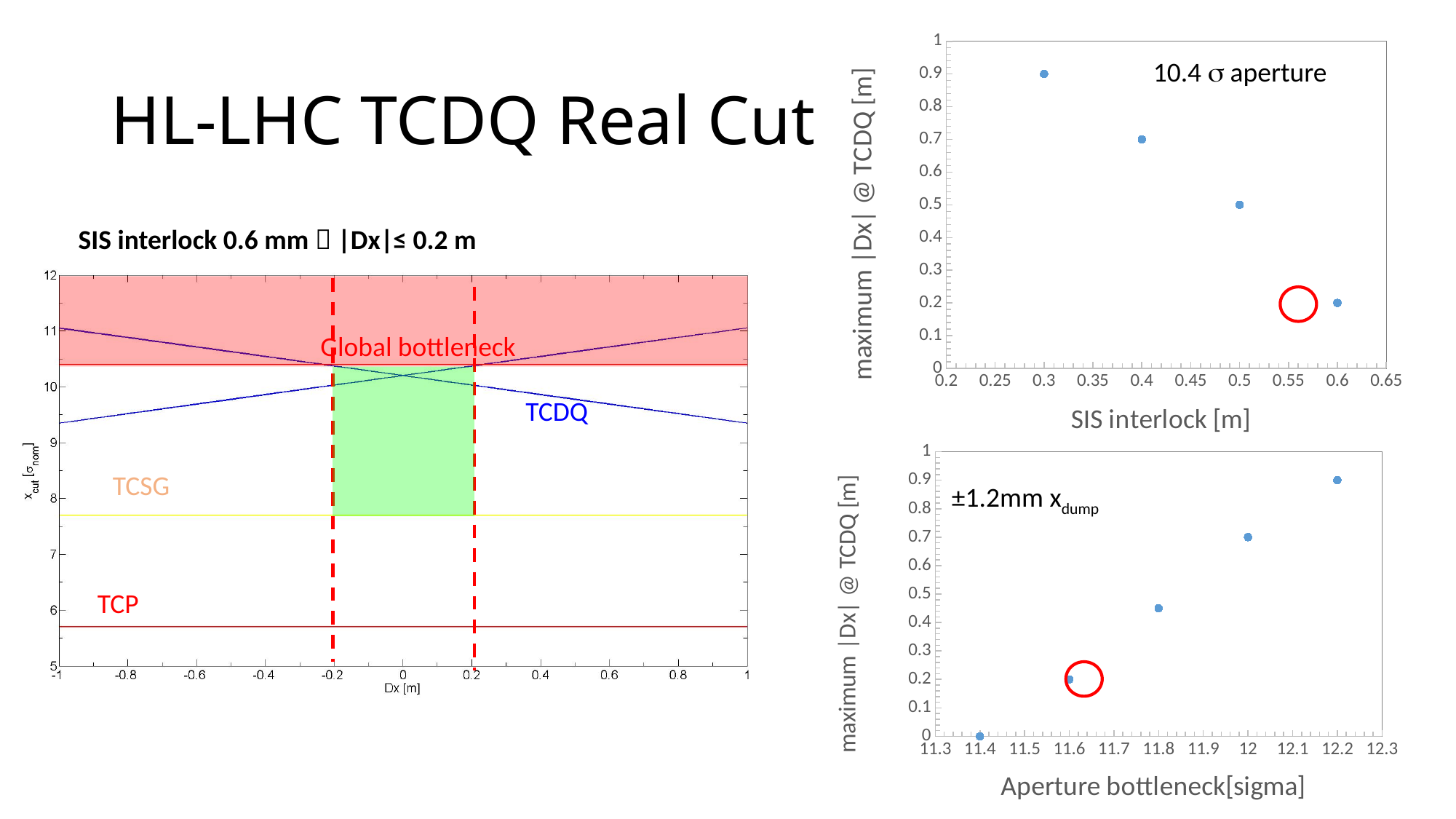
In the bottom-right chart (Aperture bottleneck[sigma]), how many data points are plotted? 5 What kind of chart is the top-right chart with x axis 'SIS interlock [m]'? scatter chart In the top-right chart (SIS interlock [m]), is the value at SIS interlock 0.3 greater or less than 0.8? greater In the top-right chart (SIS interlock [m]), how many data points are plotted? 4 In the top-right chart (SIS interlock [m]), do the values rise or fall as SIS interlock increases? fall What is the x-axis label of the left chart? Dx [m] In the top-right chart (SIS interlock [m]), at which SIS interlock value is the maximum |Dx| highest? 0.3 In the bottom-right chart (Aperture bottleneck[sigma]), do the values rise or fall as the aperture bottleneck increases? rise In the bottom-right chart (Aperture bottleneck[sigma]), at which aperture bottleneck value is the maximum |Dx| lowest? 11.4 In the top-right chart (SIS interlock [m]), is the value at SIS interlock 0.6 greater or less than 0.3? less In the top-right chart (SIS interlock [m]), which has the larger maximum |Dx|: SIS interlock 0.4 or 0.5? 0.4 In the bottom-right chart (Aperture bottleneck[sigma]), is the value at 12.2 sigma greater or less than 0.8? greater